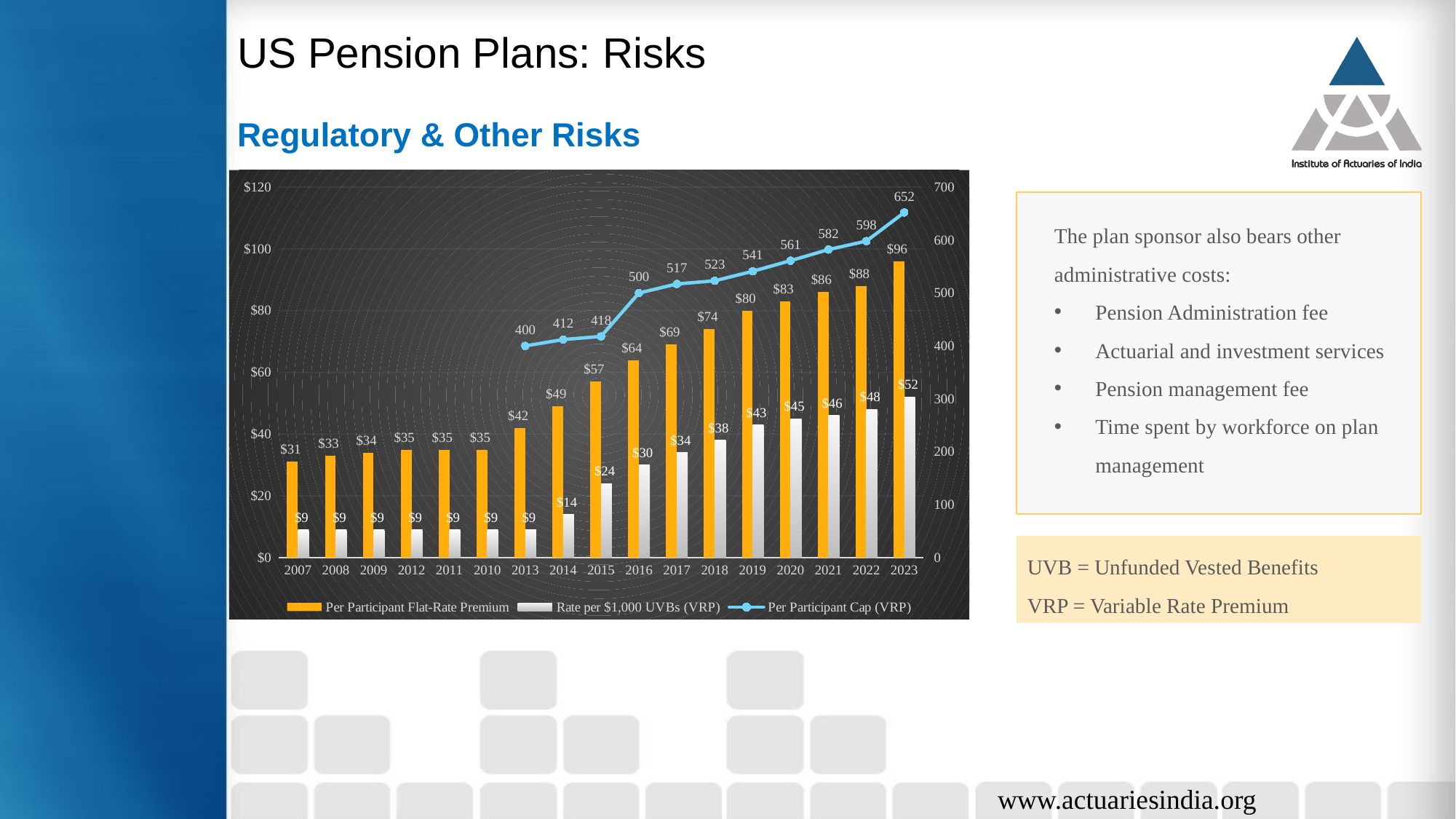
Which year has the highest Per Participant Flat-Rate Premium? 2023 How many series does the chart legend list? 3 What is the Per Participant Cap (VRP) value for 2016? 500 What is the difference between the Per Participant Flat-Rate Premium in 2023 and in 2007? $65 What is the Rate per $1,000 UVBs (VRP) for 2015? $24 What is the Per Participant Flat-Rate Premium for 2023? $96 Which series in the legend is plotted as a line rather than bars? Per Participant Cap (VRP) By how much did the Per Participant Cap (VRP) increase from 2022 to 2023? 54 How many years are shown on the x axis of the chart? 17 What kind of chart is shown on the slide? Combination bar and line chart Does the Per Participant Cap (VRP) line rise or fall from 2013 to 2023? Rise In 2018, which is larger: the Per Participant Flat-Rate Premium or the Rate per $1,000 UVBs (VRP)? Per Participant Flat-Rate Premium